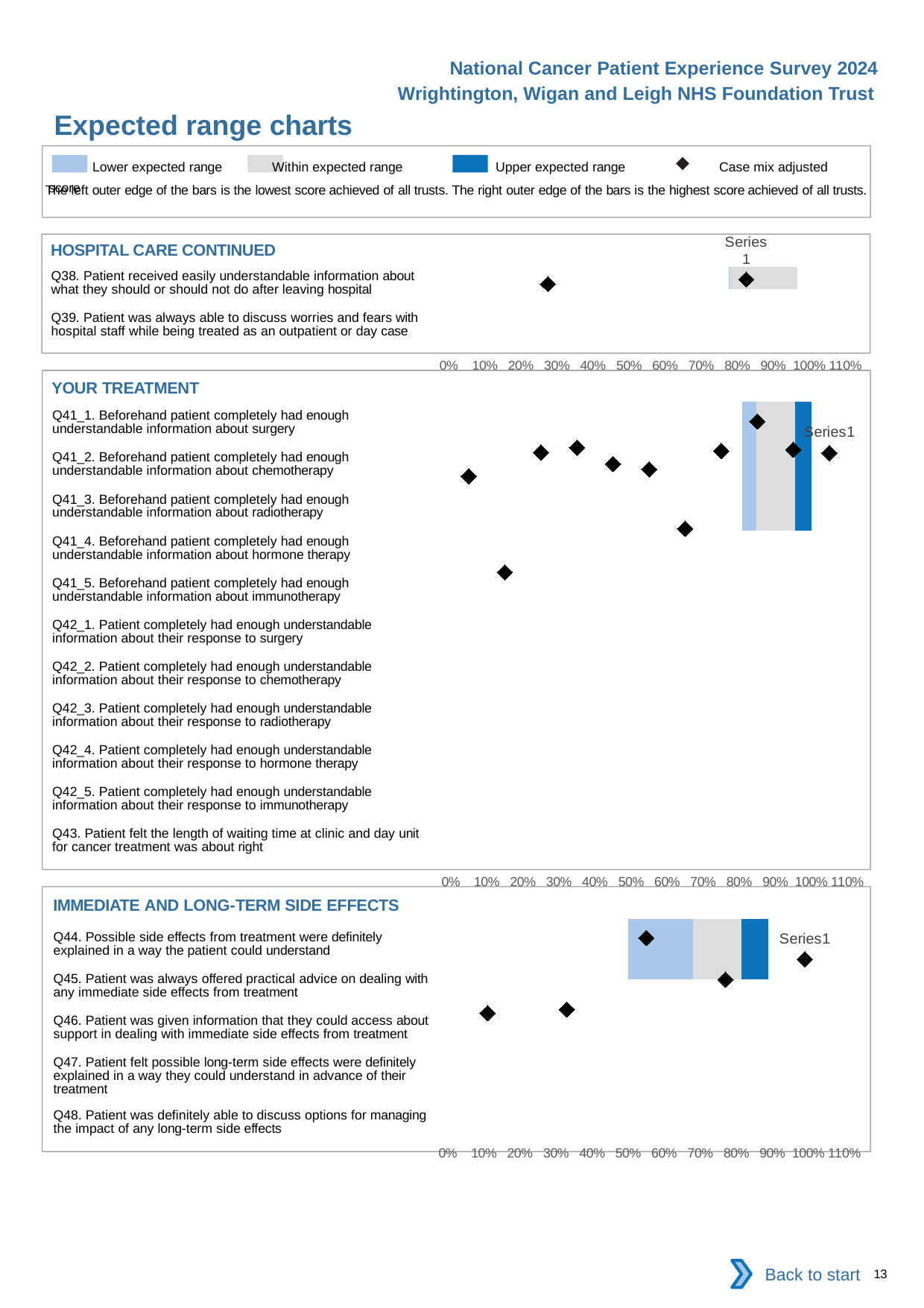
What is the highest tick label shown on the percentage axis of the YOUR TREATMENT chart? 110% How many entries does the legend at the top of the slide list? 4 In the legend, what does the black diamond marker represent? Case mix adjusted score Which of the three chart sections on the slide lists the most questions? YOUR TREATMENT In the YOUR TREATMENT chart, how many questions (categories) are listed? 11 What is the title of the slide containing the charts? Expected range charts In the IMMEDIATE AND LONG-TERM SIDE EFFECTS chart, how many questions (categories) are listed? 5 In the HOSPITAL CARE CONTINUED chart, how many questions (categories) are listed? 2